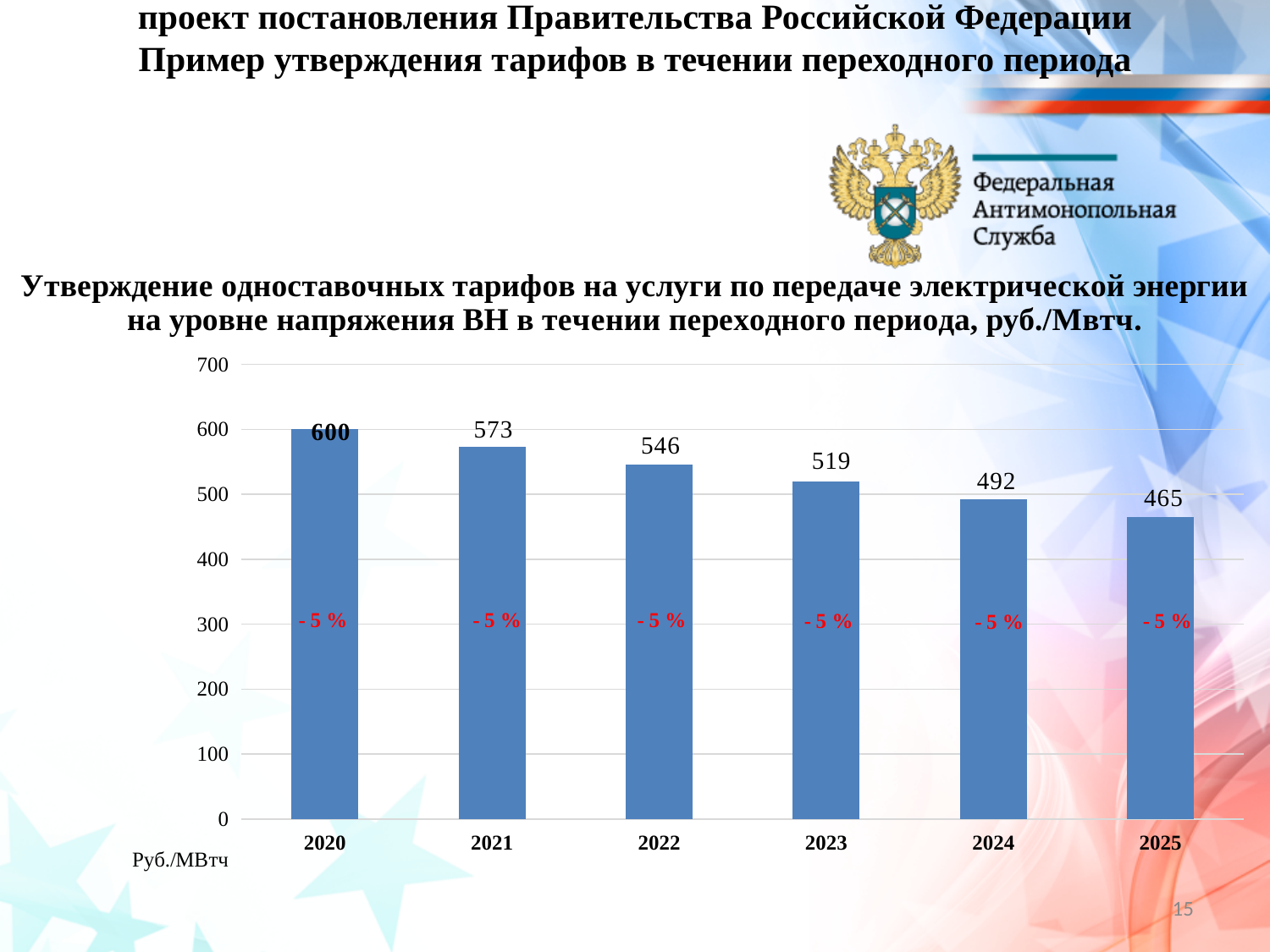
Do the tariff values rise or fall from 2020 to 2025? fall Which year has the lowest tariff value? 2025 What is the difference between the tariff values for 2020 and 2025? 135 Which year has the highest tariff value? 2020 What percentage change label is printed in red on each bar? - 5 % What is the tariff value shown for 2020? 600 What is the tariff value shown for 2023? 519 How many years are shown on the x axis? 6 What is the difference between the tariff values for 2021 and 2022? 27 Which is larger, the value for 2022 or the value for 2024? 2022 What is the tariff value shown for 2025? 465 What kind of chart is this? bar chart